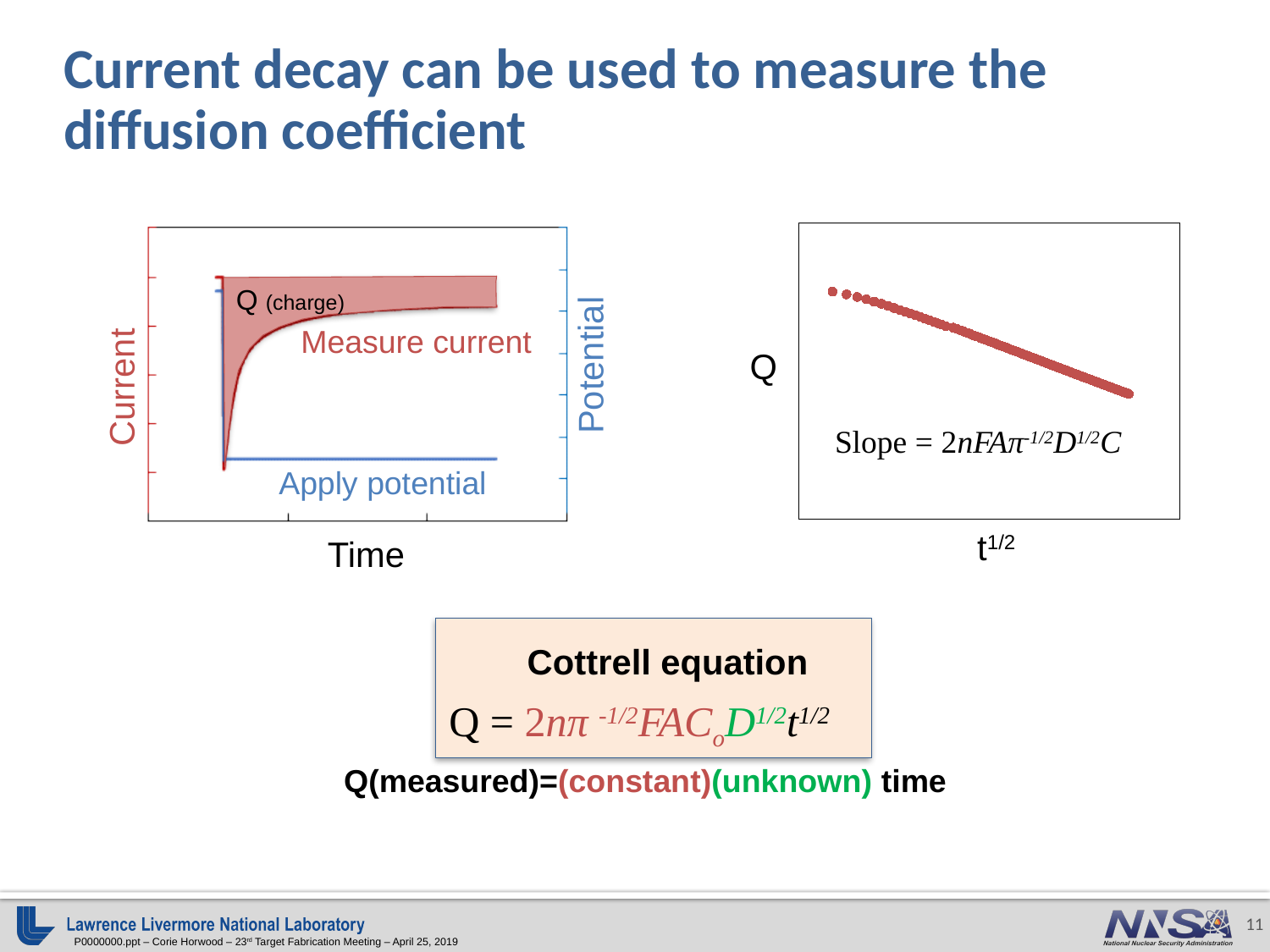
What is the label on the x axis of the right-hand chart? t^1/2 In the right-hand chart, does Q rise or fall as t^1/2 increases? fall What kind of chart is the left-hand chart (Current and Potential versus Time)? line chart What is the label on the x axis of the left-hand chart? Time What kind of chart is the right-hand chart (Q versus t^1/2)? scatter plot How many curves are plotted on the left-hand chart? 2